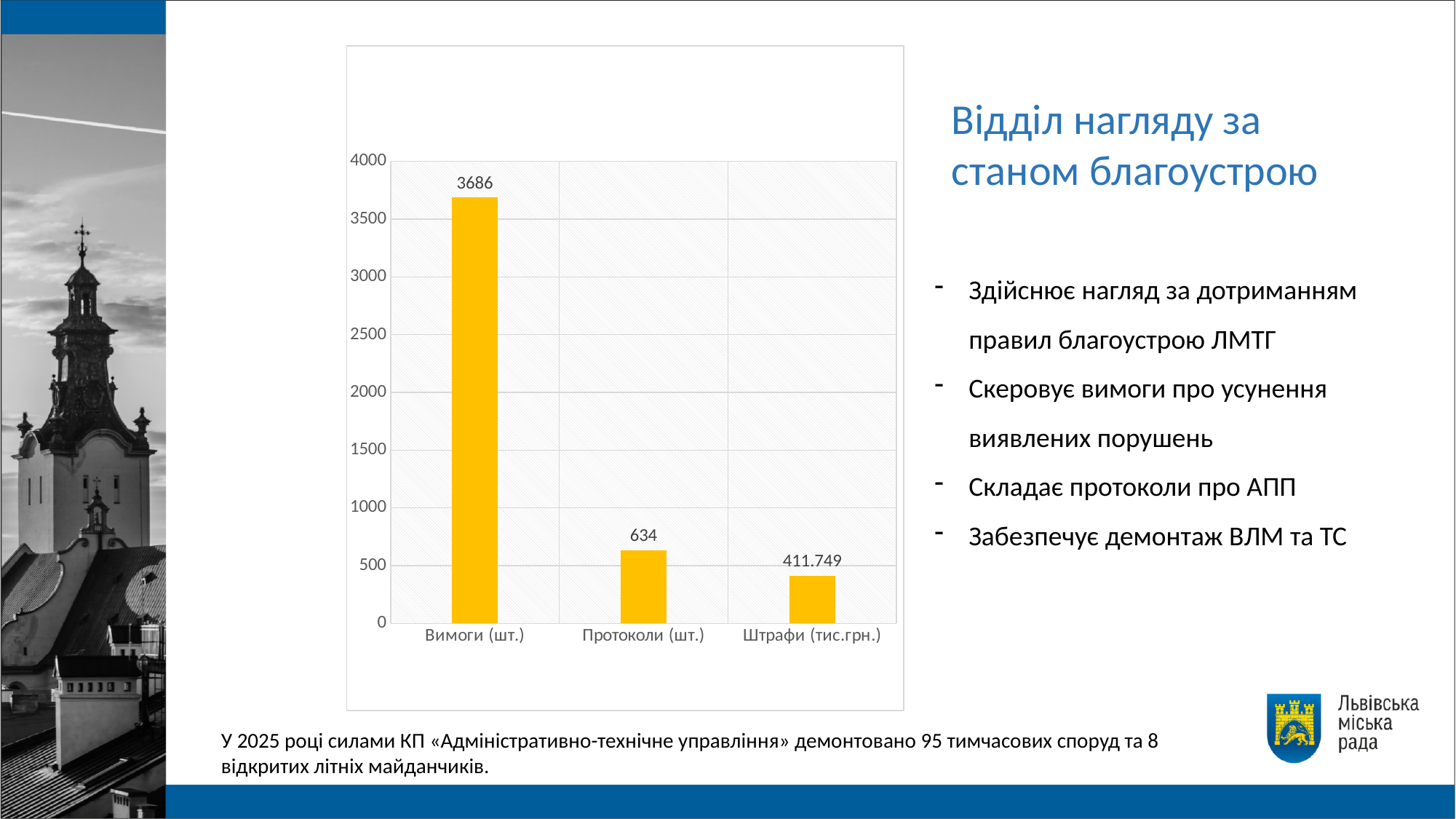
What is the difference between the values for Вимоги (шт.) and Протоколи (шт.)? 3052 Which category has the lowest value? Штрафи (тис.грн.) Which category has the highest value? Вимоги (шт.) What kind of chart is shown on the slide? bar chart Is the value for Вимоги (шт.) greater or less than 3500? greater What is the value for Штрафи (тис.грн.)? 411.749 What is the value for Вимоги (шт.)? 3686 How many categories are shown on the x axis? 3 What is the value for Протоколи (шт.)? 634 What colour are the bars in the chart? yellow Which is larger, the value for Протоколи (шт.) or the value for Штрафи (тис.грн.)? Протоколи (шт.) Is the value for Протоколи (шт.) greater or less than 1000? less